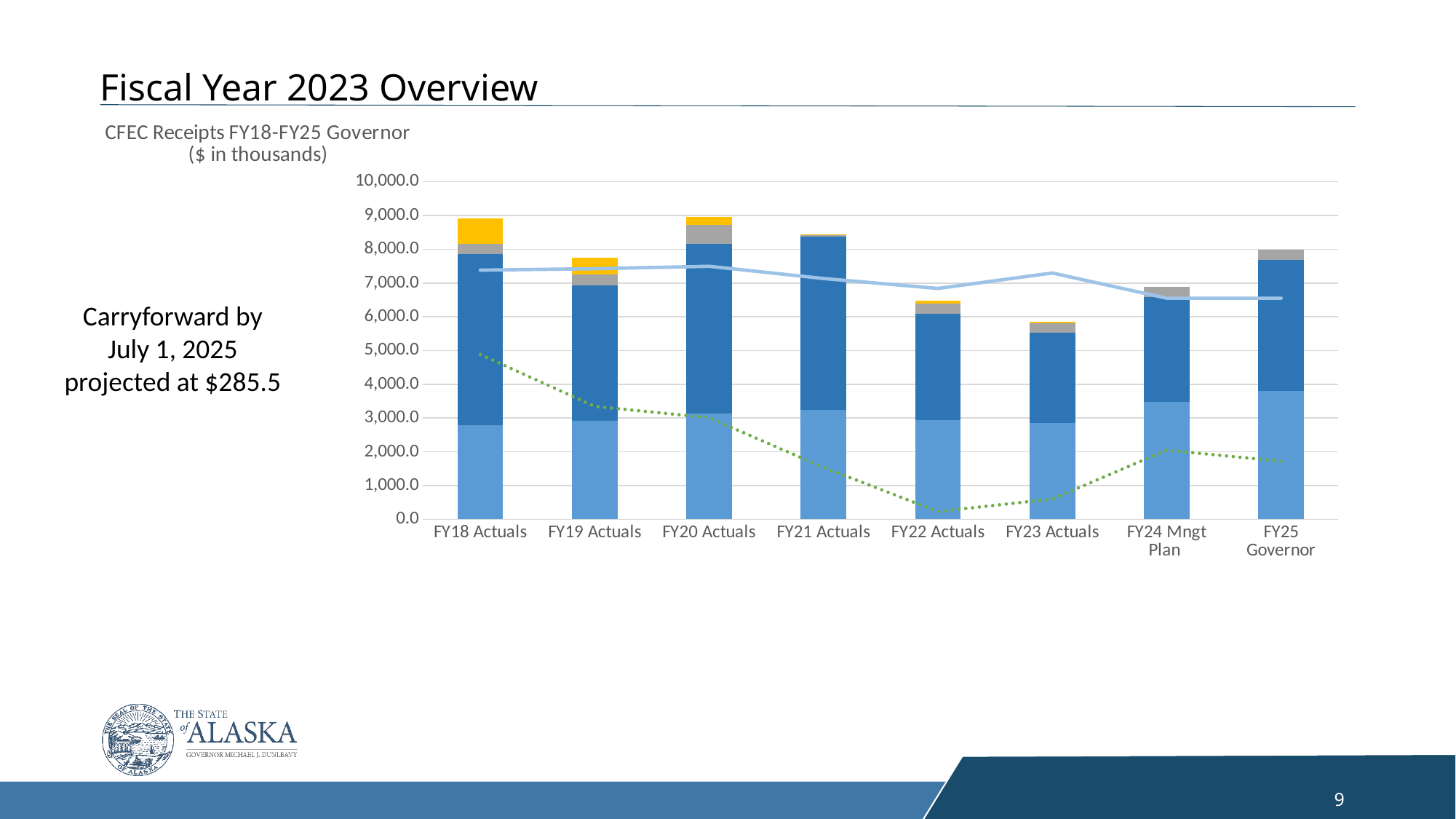
What kind of chart is shown on the slide? combination bar and line chart Is the total stacked bar for FY22 Actuals greater or less than 7,000? less Which has the larger total stacked bar, FY18 Actuals or FY23 Actuals? FY18 Actuals Is the total stacked bar for FY23 Actuals greater or less than 6,000? less Is the total stacked bar for FY21 Actuals greater or less than 8,000? greater Which category has the lowest total stacked bar? FY23 Actuals What is the highest value shown on the chart's y axis? 10,000.0 How many fiscal year categories are shown on the x axis of the chart? 8 Does the dotted green line rise or fall from FY18 Actuals to FY22 Actuals? fall What is the title of the chart? CFEC Receipts FY18-FY25 Governor ($ in thousands)